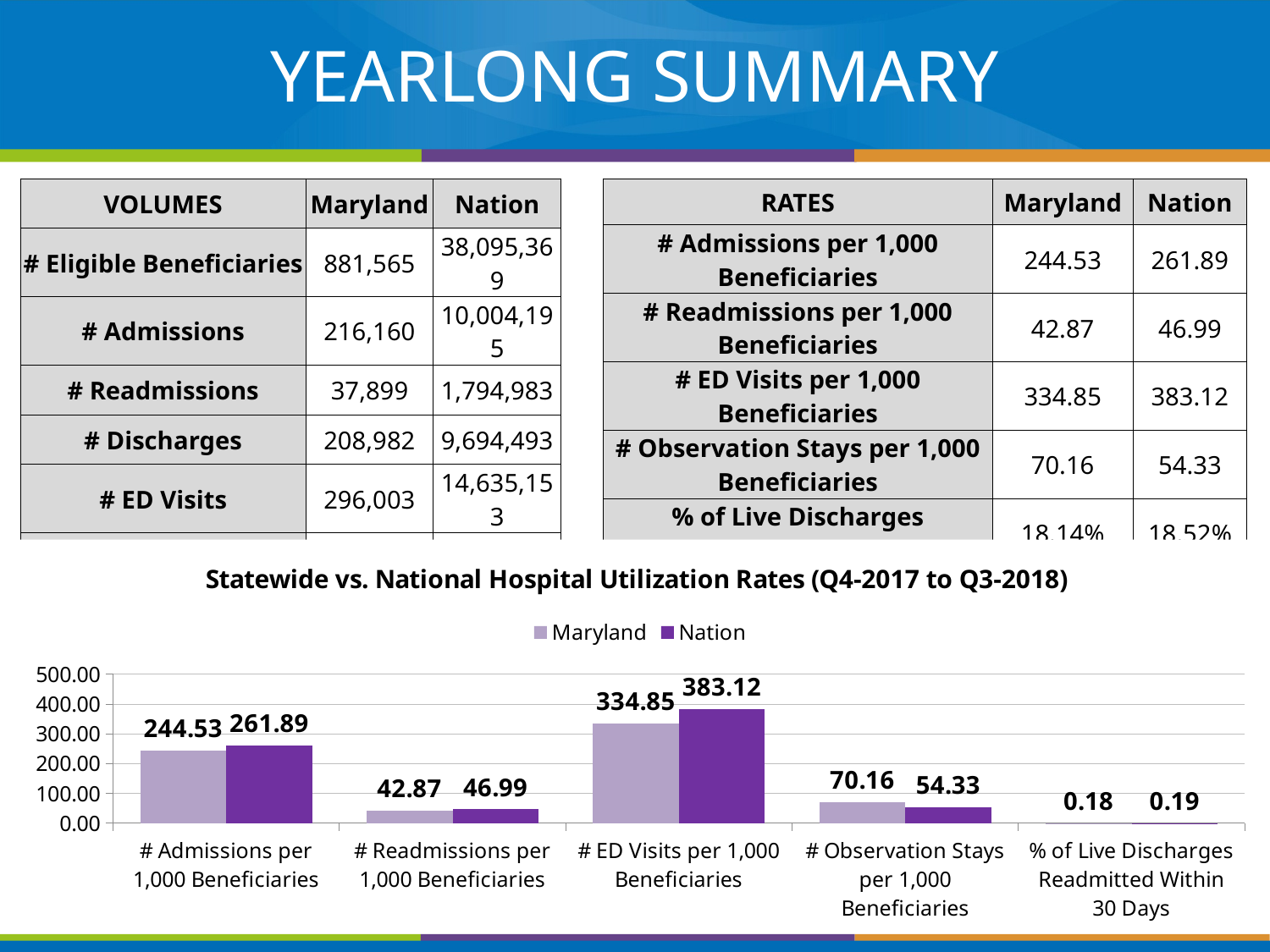
What is the Maryland value for # Admissions per 1,000 Beneficiaries in the chart? 244.53 What is the difference between the Nation and Maryland values for # ED Visits per 1,000 Beneficiaries? 48.27 Which category has the lowest Maryland value in the chart? % of Live Discharges Readmitted Within 30 Days What is the Maryland value for # Readmissions per 1,000 Beneficiaries in the chart? 42.87 Which category has the highest Nation value in the chart? # ED Visits per 1,000 Beneficiaries How many series does the chart legend list? 2 What type of chart is shown on the slide? Bar chart What is the Nation value for # Observation Stays per 1,000 Beneficiaries in the chart? 54.33 Is the Nation value for # Admissions per 1,000 Beneficiaries greater or less than 300.00? less For # Observation Stays per 1,000 Beneficiaries, which is larger: Maryland or Nation? Maryland How many categories are shown on the x axis of the chart? 5 What is the Nation value for # ED Visits per 1,000 Beneficiaries in the chart? 383.12